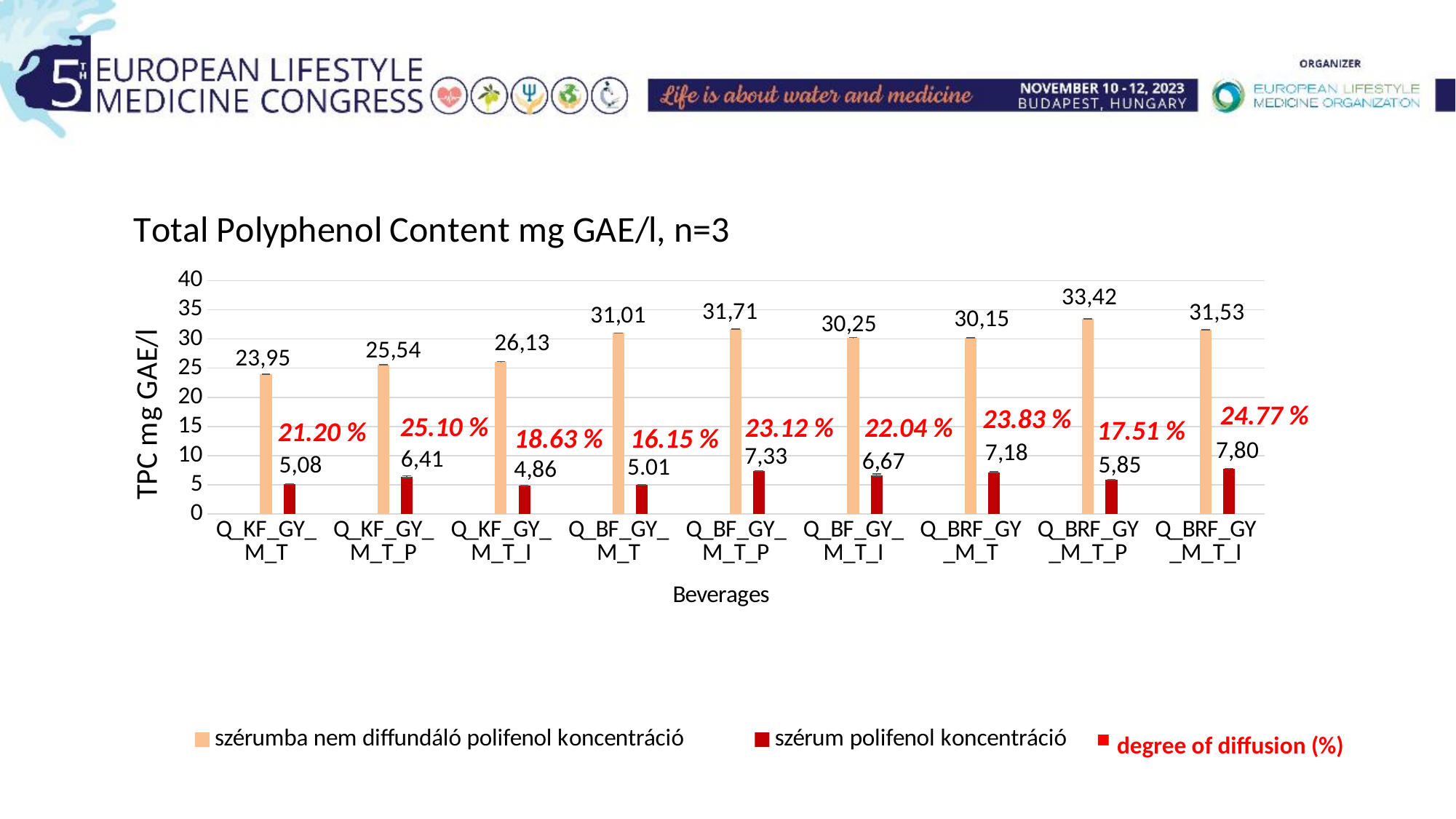
Which beverage has the highest szérumba nem diffundáló polifenol koncentráció value? Q_BRF_GY_M_T_P What is the szérum polifenol koncentráció value for Q_BF_GY_M_T_P? 7,33 What is the difference between the highest and lowest szérumba nem diffundáló polifenol koncentráció values (33,42 and 23,95)? 9,47 Which beverage has the lowest szérum polifenol koncentráció value? Q_KF_GY_M_T_I What is the title of the chart? Total Polyphenol Content mg GAE/l, n=3 What is the value of the szérumba nem diffundáló polifenol koncentráció series for Q_BRF_GY_M_T_P? 33,42 How many series does the legend list? 3 What degree of diffusion (%) is shown for Q_KF_GY_M_T_I? 18.63 % Which beverage has the lowest degree of diffusion (%)? Q_BF_GY_M_T What kind of chart is shown on the slide? Bar chart How many beverages are shown on the x axis? 9 Which is larger, the szérum polifenol koncentráció for Q_KF_GY_M_T_P or for Q_BRF_GY_M_T_P? Q_KF_GY_M_T_P